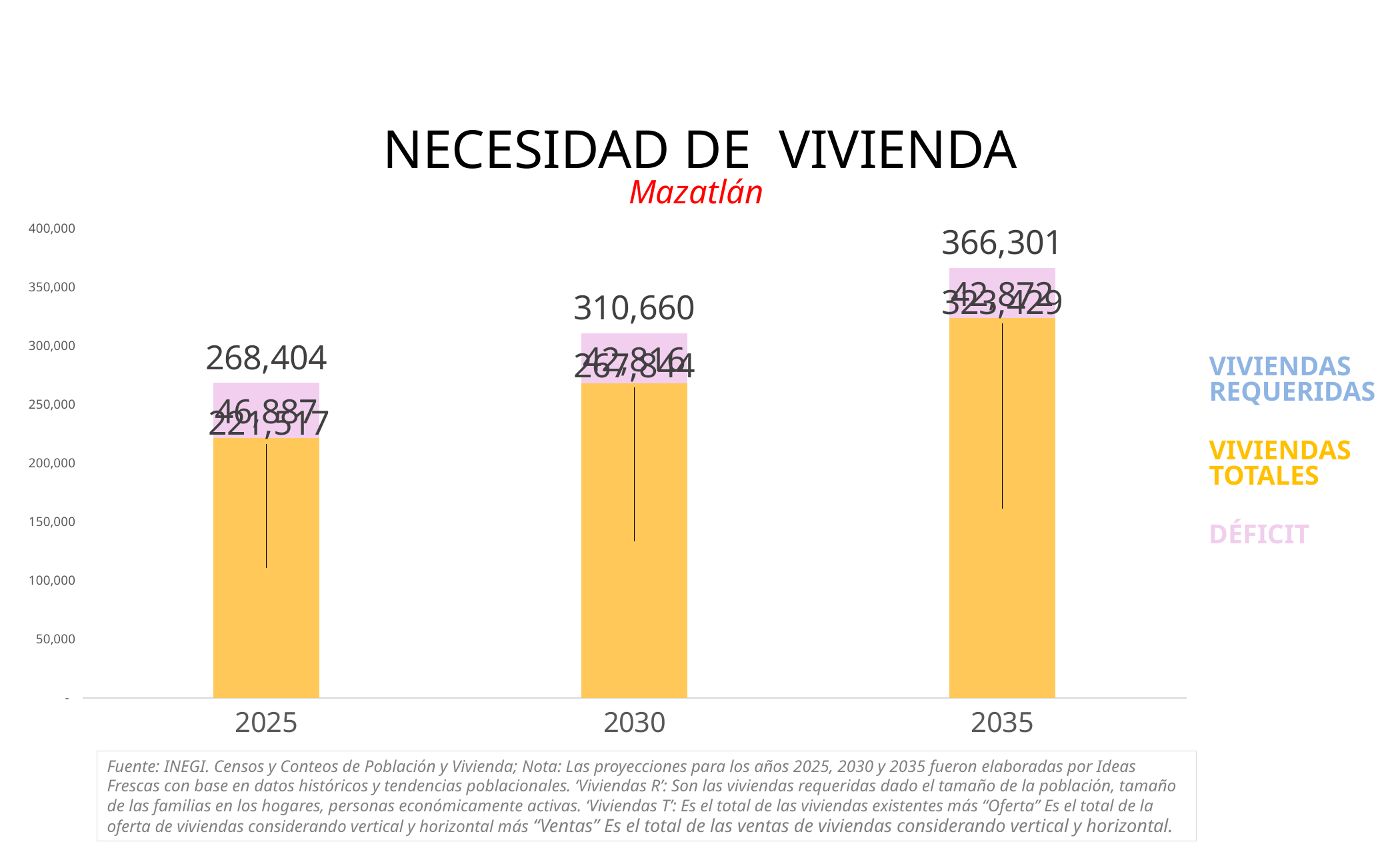
What is the value labelled at the top of the 2025 bar? 268,404 Is the yellow (Viviendas Totales) segment for 2030 greater or less than 250,000? greater Which year has the highest total value at the top of its bar? 2035 What is the value of the yellow (Viviendas Totales) segment for 2025? 221,517 What is the value labelled at the top of the 2035 bar? 366,301 Which year has the lowest total value at the top of its bar? 2025 What is the value labelled at the top of the 2030 bar? 310,660 What is the difference between the top values for 2035 and 2025? 97,897 How many entries does the legend list? 3 Do the top values of the bars rise or fall from 2025 to 2035? rise How many years are shown on the x axis? 3 Which is larger, the top value for 2030 or for 2025? 2030